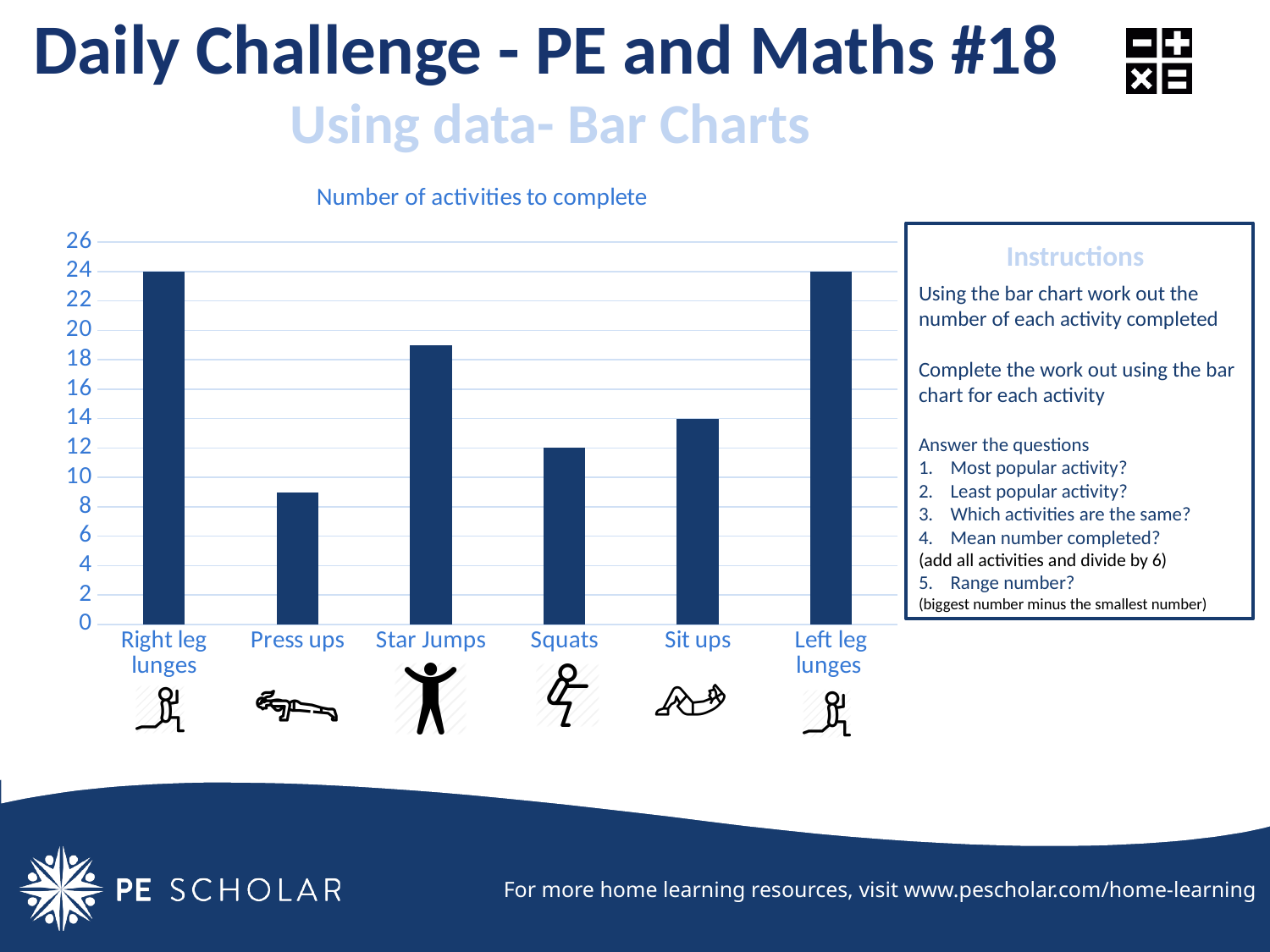
Which activity has the lowest value? Press ups How many activities are shown on the chart? 6 Which is larger, the value for Sit ups or the value for Squats? Sit ups What is the value for Squats? 12 What is the value for Left leg lunges? 24 Is the value for Star Jumps greater or less than 18? greater What is the value for Right leg lunges? 24 What is the value for Sit ups? 14 Is the value for Press ups greater or less than 10? less What is the difference between the value for Right leg lunges and the value for Squats? 12 What type of chart is shown on the slide? Bar chart What is the title of the chart? Number of activities to complete